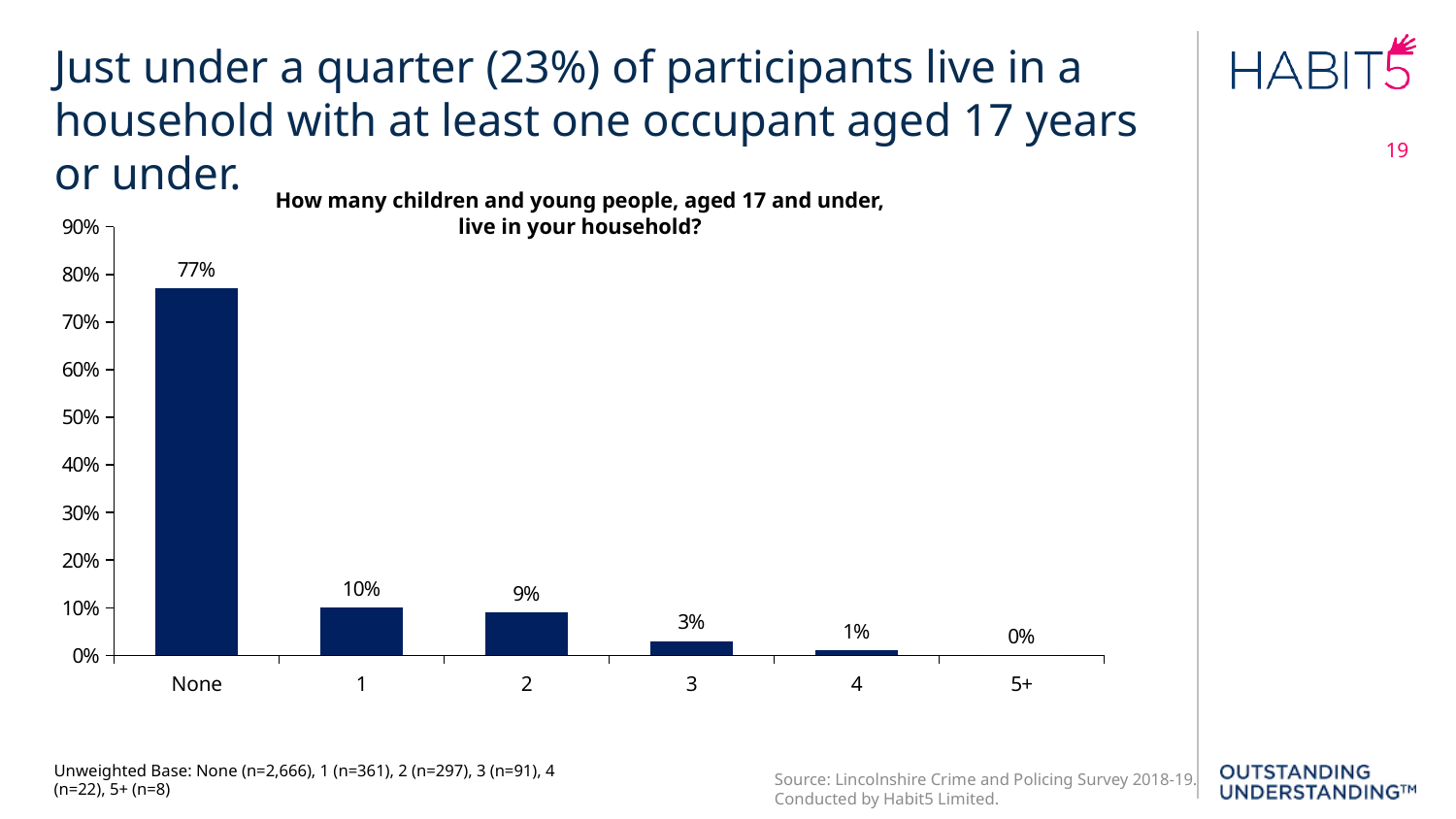
What percentage of participants have no children aged 17 and under in their household? 77% What is the title of the chart? How many children and young people, aged 17 and under, live in your household? What is the difference between the values for '1' and '2'? 1 percentage point How many categories are shown on the x axis? 6 What kind of chart is shown on the slide? Bar chart What is the difference between the values for 'None' and '1'? 67 percentage points Which category has the highest value? None What is the value for households with 4 children aged 17 and under? 1% Which is larger, the value for 3 children or the value for 4 children? 3 children Which category has the lowest value? 5+ Is the value for 'None' greater or less than 70%? greater What is the value for households with 2 children aged 17 and under? 9%